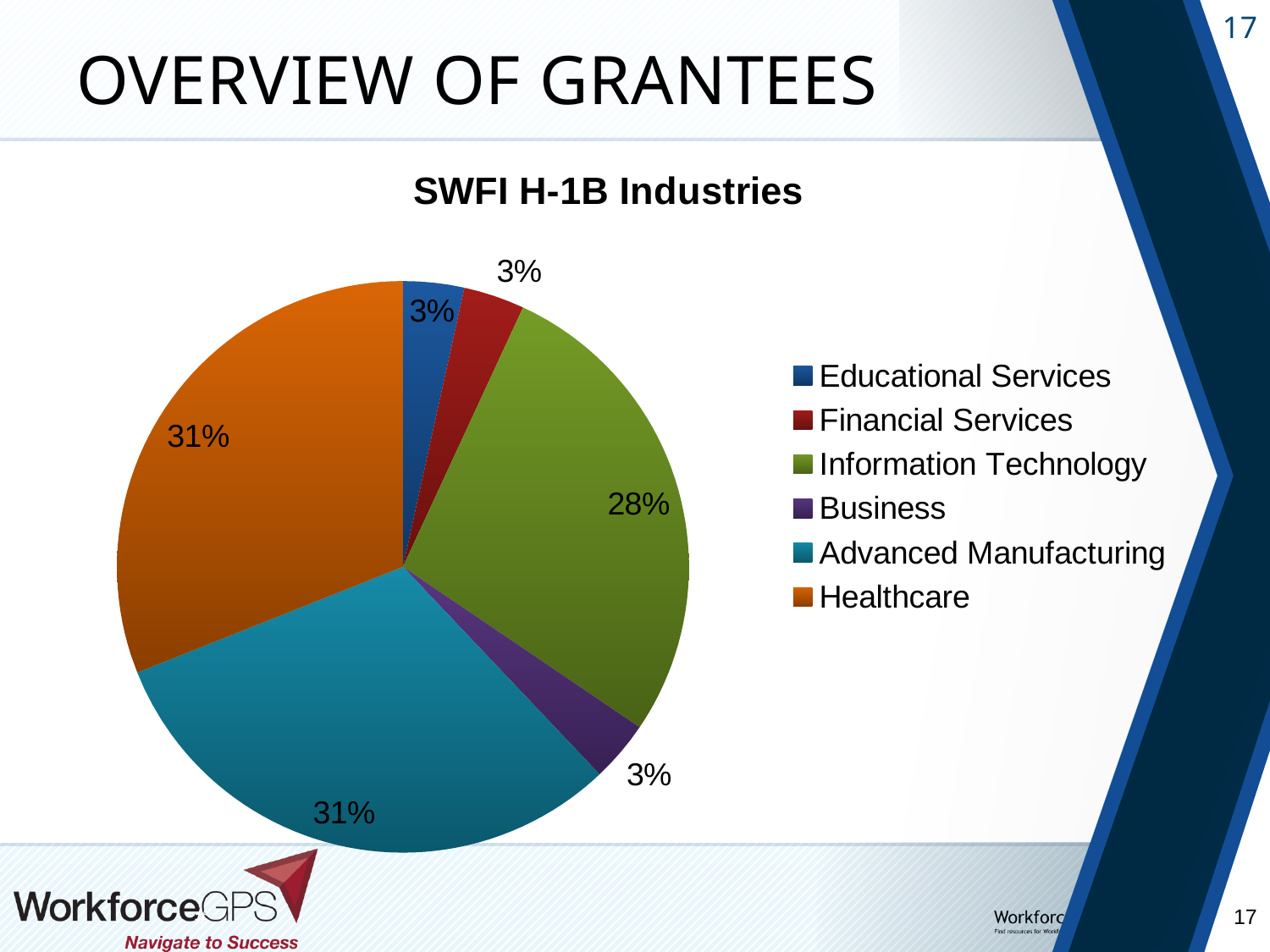
What share of the pie does Healthcare represent? 31% What is the difference in percentage points between the Healthcare share and the Information Technology share? 3 Which is larger, the share for Healthcare or the share for Information Technology? Healthcare What share of the pie does Educational Services represent? 3% Which colour represents Advanced Manufacturing in the chart? teal What type of chart is shown on the slide? pie chart What share of the pie does Advanced Manufacturing represent? 31% How many categories does the legend list? 6 What is the title of the chart? SWFI H-1B Industries